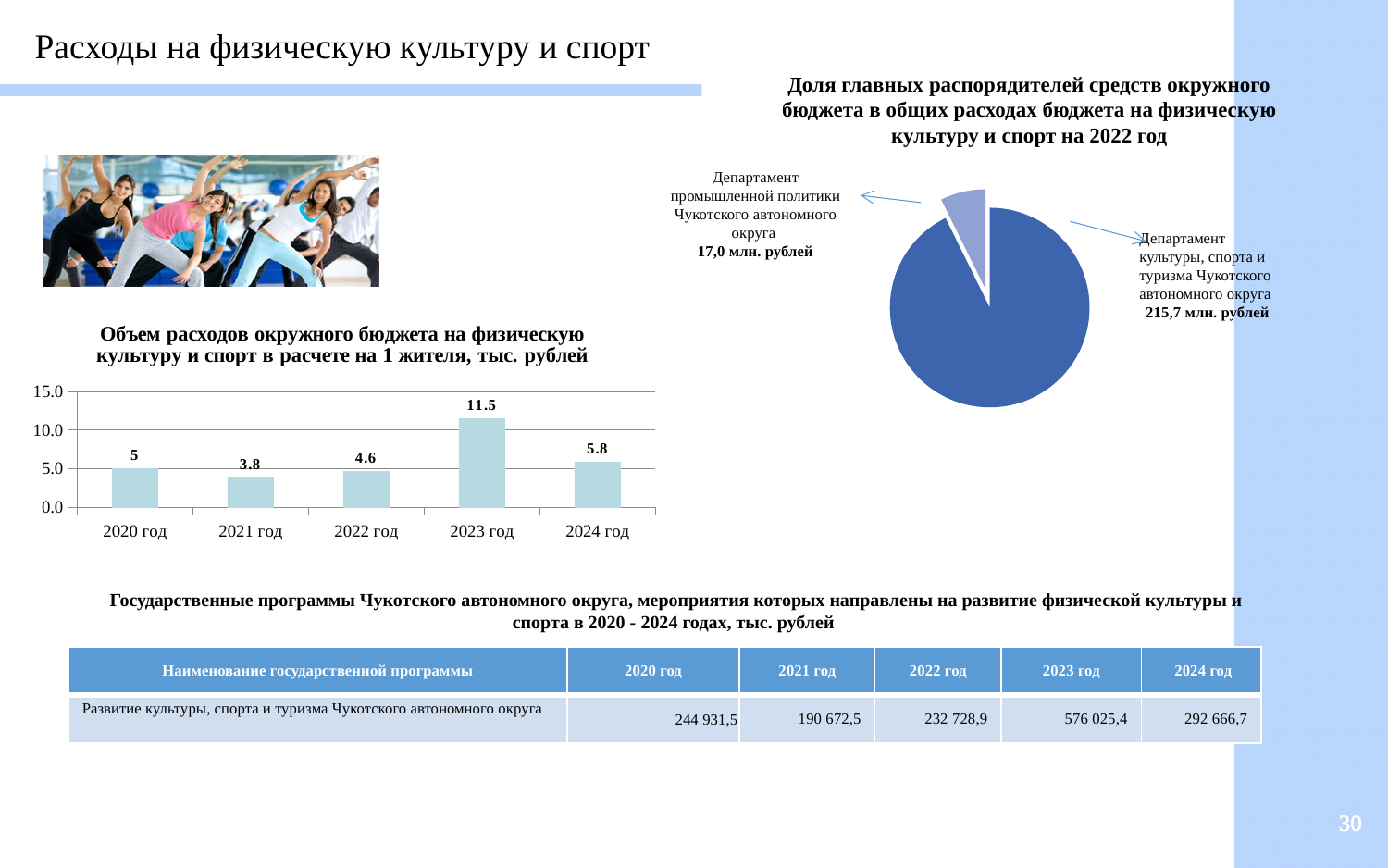
На столбчатой диаграмме «Объем расходов окружного бюджета на физическую культуру и спорт в расчете на 1 жителя» в каком году значение наибольшее? 2023 год Сколько лет (категорий) показано на столбчатой диаграмме «Объем расходов окружного бюджета на физическую культуру и спорт в расчете на 1 жителя»? 5 На столбчатой диаграмме «Объем расходов окружного бюджета на физическую культуру и спорт в расчете на 1 жителя» какое значение указано для 2021 года? 3.8 На столбчатой диаграмме «Объем расходов окружного бюджета на физическую культуру и спорт в расчете на 1 жителя» в каком году значение наименьшее? 2021 год Сколько секторов на круговой диаграмме «Доля главных распорядителей средств окружного бюджета в общих расходах бюджета на физическую культуру и спорт на 2022 год»? 2 На столбчатой диаграмме «Объем расходов окружного бюджета на физическую культуру и спорт в расчете на 1 жителя» какое значение указано для 2023 года? 11.5 На столбчатой диаграмме «Объем расходов окружного бюджета на физическую культуру и спорт в расчете на 1 жителя» на сколько значение 2023 года больше значения 2024 года? 5.7 На круговой диаграмме «Доля главных распорядителей средств окружного бюджета в общих расходах бюджета на физическую культуру и спорт на 2022 год» какая сумма указана для Департамента культуры, спорта и туризма Чукотского автономного округа? 215,7 млн. рублей Какого типа диаграмма «Объем расходов окружного бюджета на физическую культуру и спорт в расчете на 1 жителя»? bar chart На столбчатой диаграмме «Объем расходов окружного бюджета на физическую культуру и спорт в расчете на 1 жителя» значение за 2023 год больше или меньше 10.0? greater На столбчатой диаграмме «Объем расходов окружного бюджета на физическую культуру и спорт в расчете на 1 жителя» какое значение больше: за 2020 год или за 2022 год? 2020 год На круговой диаграмме «Доля главных распорядителей средств окружного бюджета в общих расходах бюджета на физическую культуру и спорт на 2022 год» какая сумма указана для Департамента промышленной политики Чукотского автономного округа? 17,0 млн. рублей